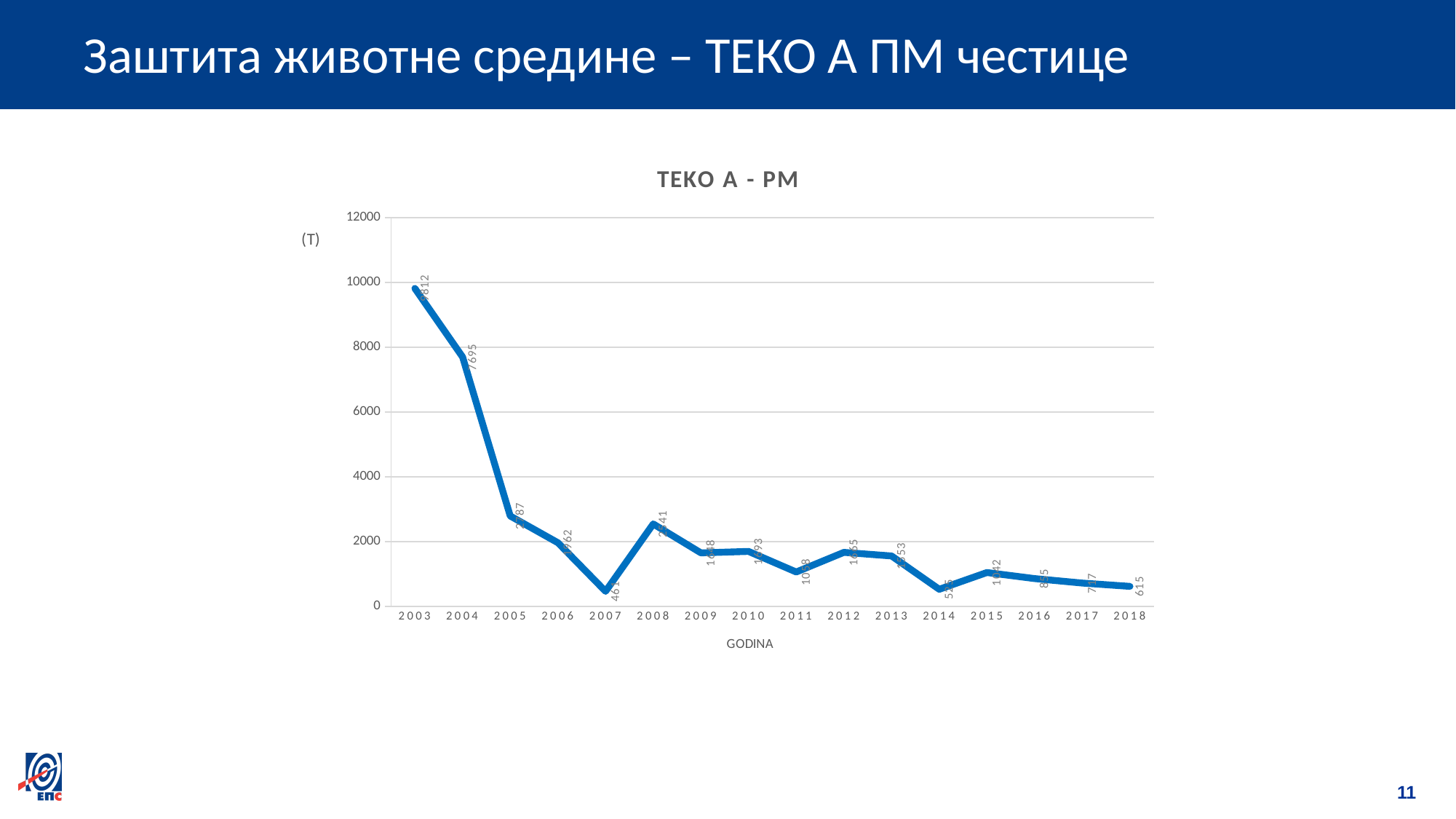
Which year has the highest value in the TEKO A - PM chart? 2003 What is the value for 2004 in the TEKO A - PM chart? 7695 What is the value for 2003 in the TEKO A - PM chart? 9812 What is the value for 2017 in the TEKO A - PM chart? 717 Which year has the larger value, 2016 or 2017? 2016 Is the value for 2014 greater or less than 1000? less What is the value for 2018 in the TEKO A - PM chart? 615 Which year has the lowest value in the TEKO A - PM chart? 2007 By how much did the value fall from 2003 to 2004 in the TEKO A - PM chart? 2117 What is the title of the x axis in the chart? GODINA What kind of chart is shown on the slide? line chart How many years are plotted on the x axis of the TEKO A - PM chart? 16